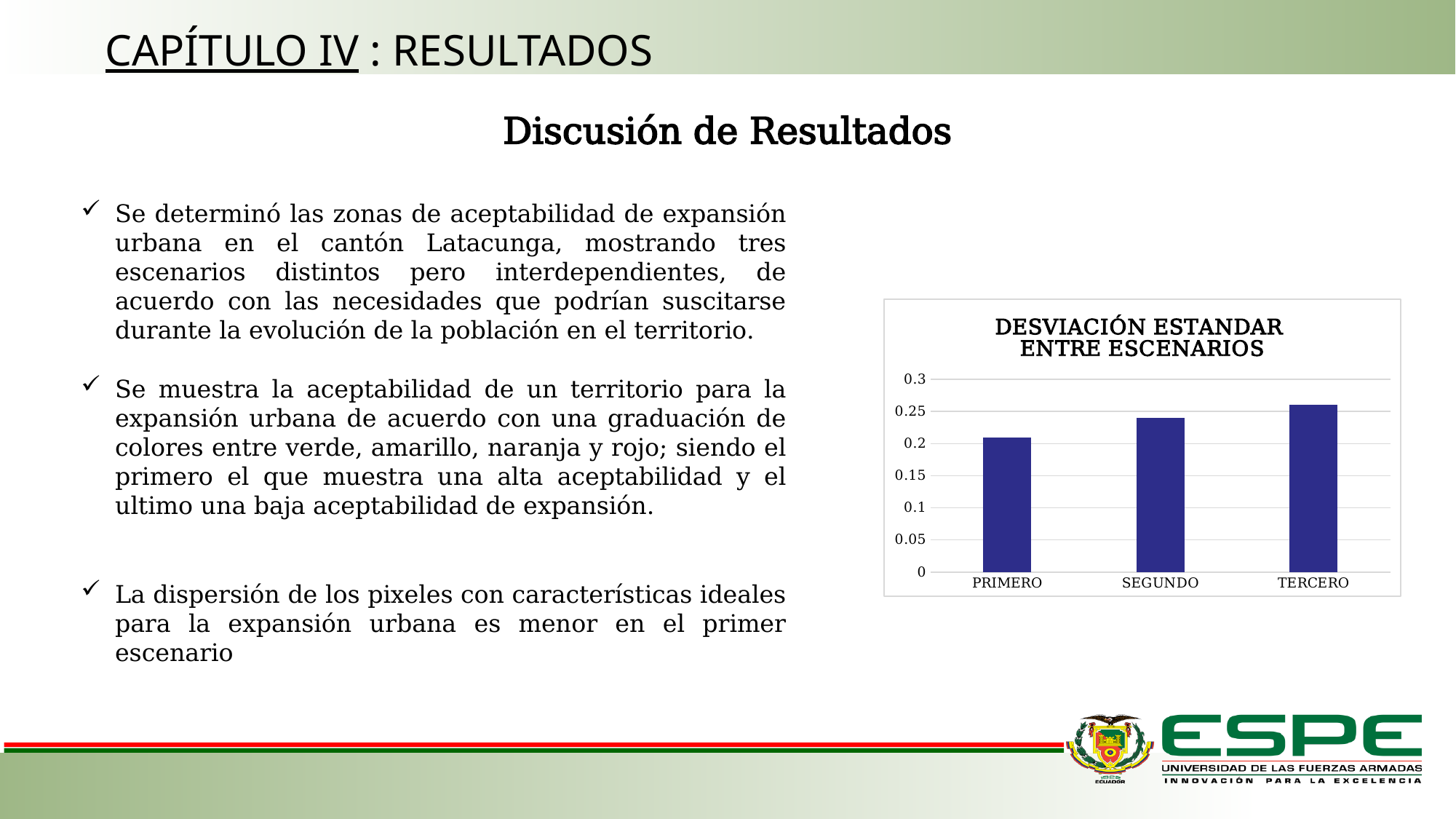
Is the value for PRIMERO greater or less than 0.15? greater How many categories are shown on the x axis of the chart? 3 What is the title of the chart? DESVIACIÓN ESTANDAR ENTRE ESCENARIOS What kind of chart is shown on the slide? bar chart Do the values rise or fall from PRIMERO to TERCERO along the x axis? rise Which category has the highest bar in the chart? TERCERO Is the value for PRIMERO greater or less than 0.25? less Is the value for SEGUNDO greater or less than 0.2? greater Which is larger, the value for TERCERO or the value for PRIMERO? TERCERO Which category has the lowest bar in the chart? PRIMERO Which is larger, the value for SEGUNDO or the value for PRIMERO? SEGUNDO